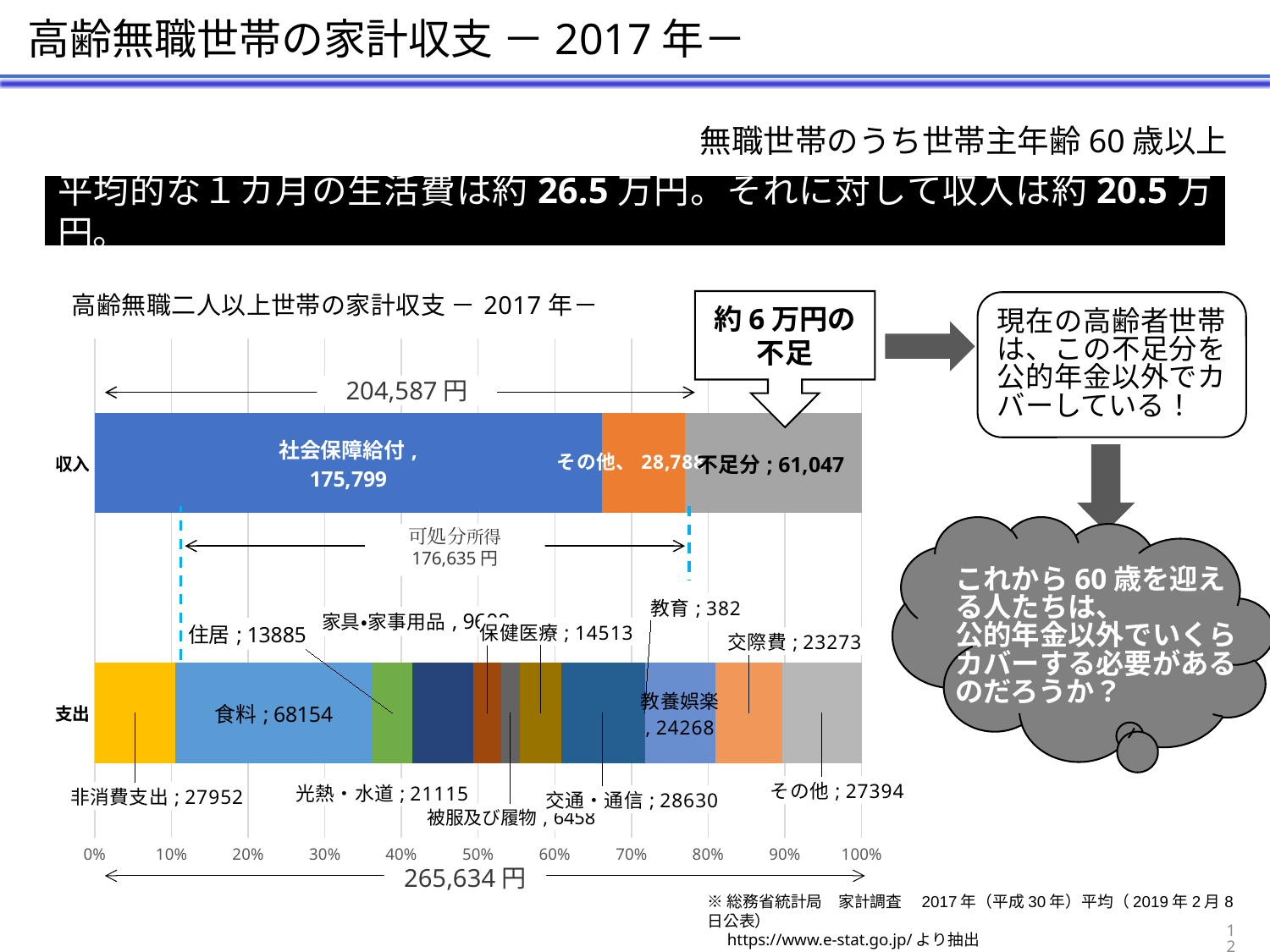
Which is larger in the 支出 bar, 非消費支出 or その他? 非消費支出 What is the value of 教育 in the 支出 bar? 382 What is the difference between 交通・通信 and 光熱・水道 in the 支出 bar? 7515 What is the value of 社会保障給付 in the 収入 bar? 175,799 What is the value of 交際費 in the 支出 bar? 23273 What is the title of the chart? 高齢無職二人以上世帯の家計収支 － 2017年－ What is the value of 食料 in the 支出 bar? 68154 What is the value of 不足分 in the 収入 bar? 61,047 What kind of chart is shown on the slide? stacked bar chart What total amount is shown for the 支出 bar? 265,634円 Which segment of the 支出 bar has the smallest value? 教育 Which segment of the 支出 bar has the largest value? 食料